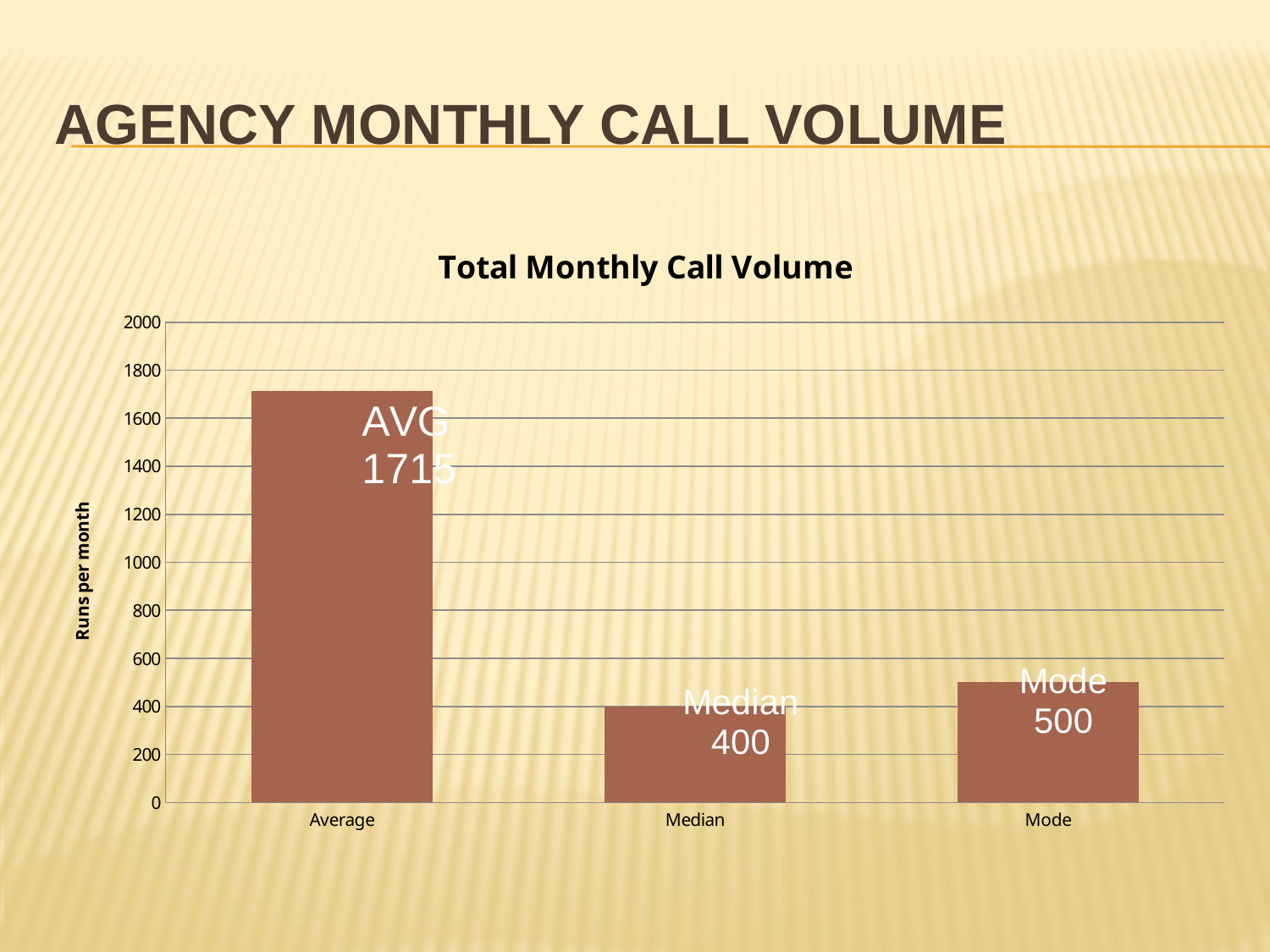
Which category has the lowest value in the Total Monthly Call Volume chart? Median What is the difference between the Average and Median values in the Total Monthly Call Volume chart? 1315 What kind of chart is the Total Monthly Call Volume chart? bar chart What is the value for Mode in the Total Monthly Call Volume chart? 500 Which category has the highest value in the Total Monthly Call Volume chart? Average How many categories are shown in the Total Monthly Call Volume chart? 3 What is the value for Average in the Total Monthly Call Volume chart? 1715 Is the value for Average greater or less than 1600 in the Total Monthly Call Volume chart? greater What is the value for Median in the Total Monthly Call Volume chart? 400 What is the difference between the Mode and Median values in the Total Monthly Call Volume chart? 100 Which is larger in the Total Monthly Call Volume chart, Mode or Median? Mode What is the label on the vertical axis of the Total Monthly Call Volume chart? Runs per month